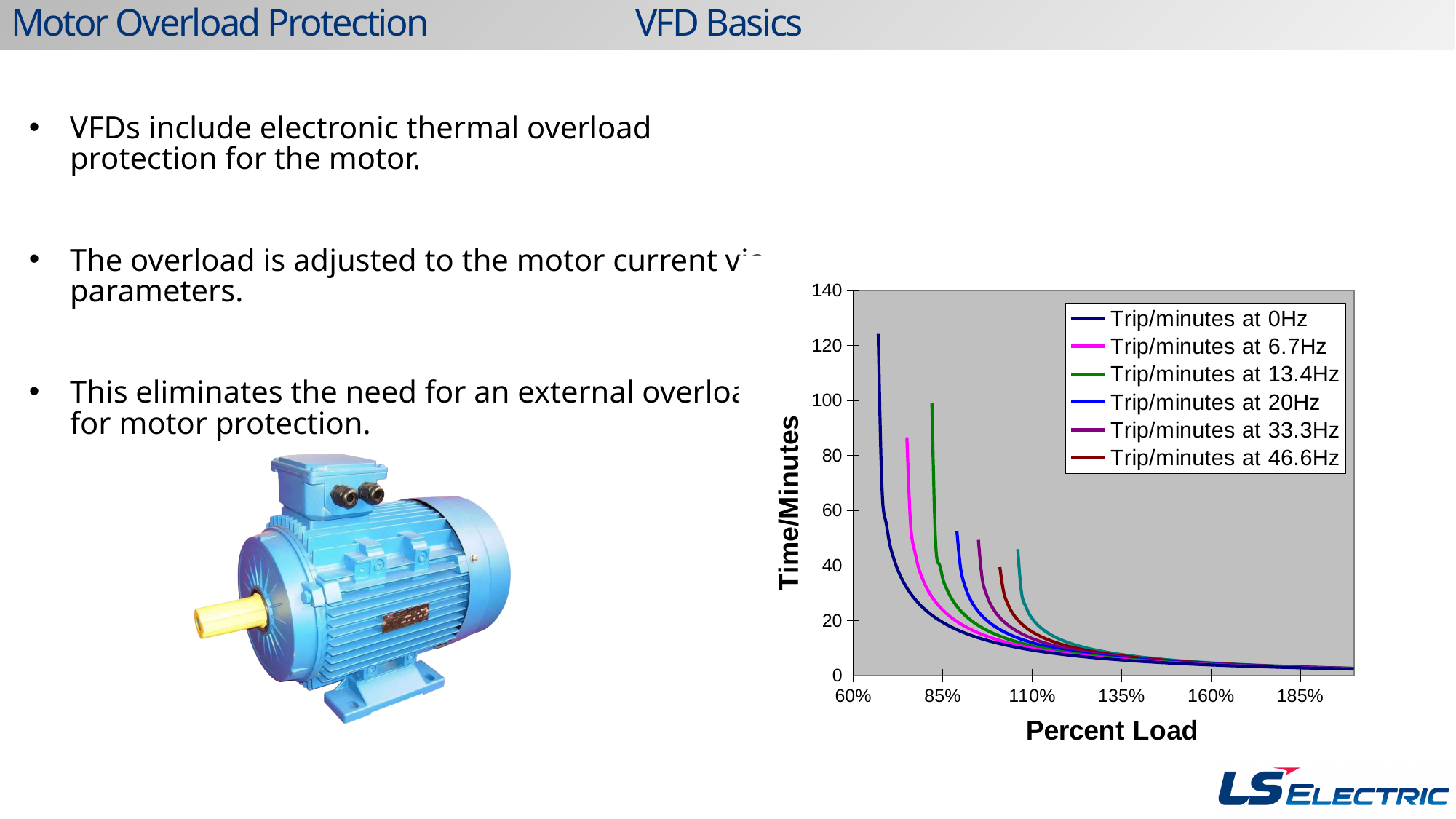
Is the maximum value of the Trip/minutes at 20Hz curve greater or less than 40? greater How many series does the chart legend list? 6 Is the maximum value of the Trip/minutes at 0Hz curve greater or less than 100? greater What kind of chart is shown on the slide? line chart What is the label of the chart's horizontal axis? Percent Load What is the highest value shown on the chart's vertical axis? 140 Which series reaches the highest trip time on the chart? Trip/minutes at 0Hz What is the label of the chart's vertical axis? Time/Minutes Which curve peaks higher, Trip/minutes at 0Hz or Trip/minutes at 46.6Hz? Trip/minutes at 0Hz As percent load increases along the x axis, do the trip times rise or fall? fall Is the maximum value of the Trip/minutes at 6.7Hz curve greater or less than 80? greater